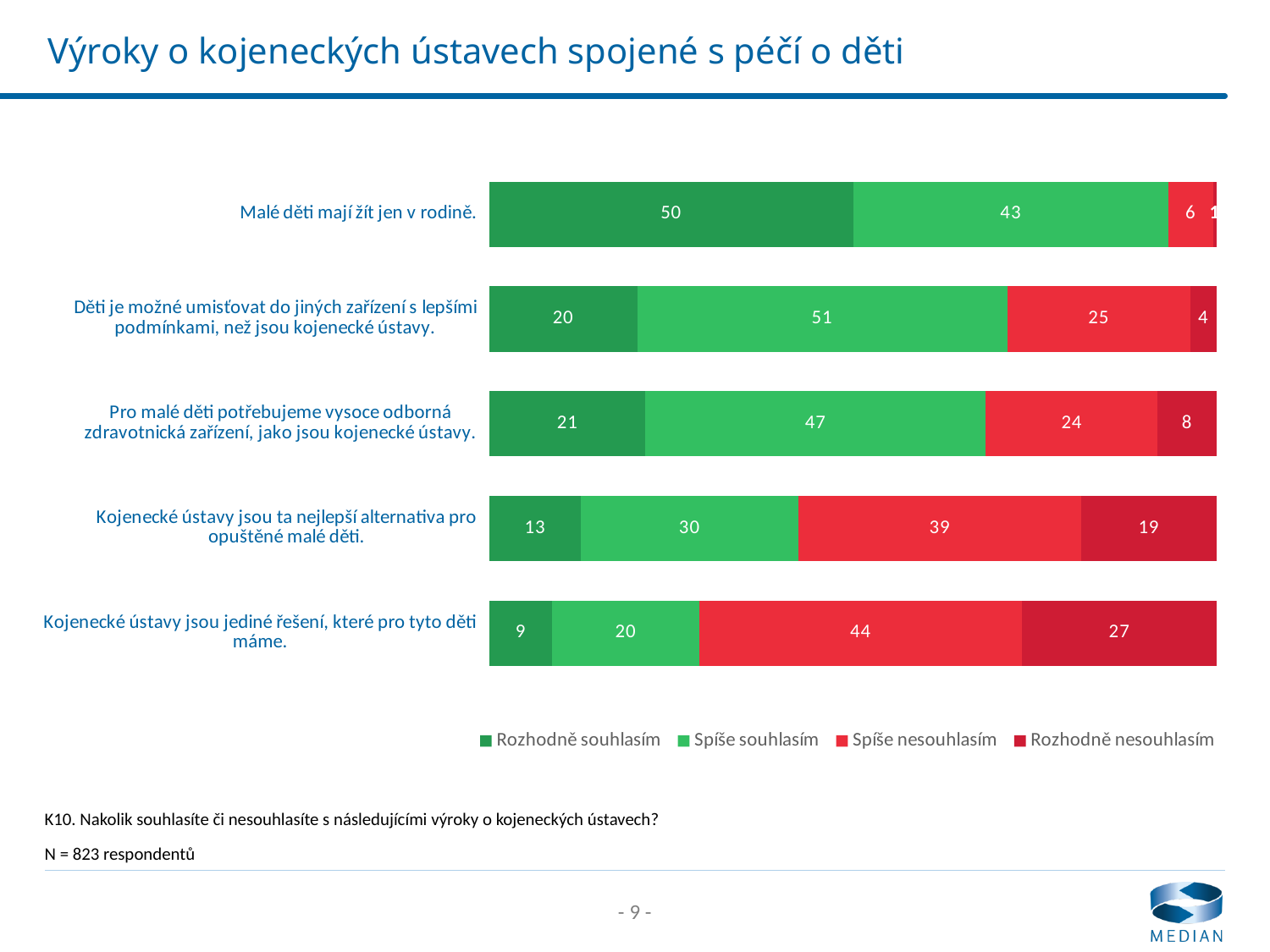
What is the value for "Rozhodně souhlasím" for the statement "Malé děti mají žít jen v rodině."? 50 What is the value for "Spíše nesouhlasím" for the statement "Kojenecké ústavy jsou jediné řešení, které pro tyto děti máme."? 44 How many series does the legend list? 4 What kind of chart is shown on the slide? Stacked bar chart What is the total of the stacked bar for "Pro malé děti potřebujeme vysoce odborná zdravotnická zařízení, jako jsou kojenecké ústavy."? 100 Which legend entry is shown in the darkest green colour? Rozhodně souhlasím Which statement has the lowest value for "Rozhodně souhlasím"? Kojenecké ústavy jsou jediné řešení, které pro tyto děti máme. How many statements are shown in the chart? 5 Which statement has the larger "Spíše nesouhlasím" value: "Kojenecké ústavy jsou ta nejlepší alternativa pro opuštěné malé děti." or "Kojenecké ústavy jsou jediné řešení, které pro tyto děti máme."? Kojenecké ústavy jsou jediné řešení, které pro tyto děti máme. Which statement has the highest value for "Rozhodně souhlasím"? Malé děti mají žít jen v rodině. What is the value for "Rozhodně nesouhlasím" for the statement "Kojenecké ústavy jsou ta nejlepší alternativa pro opuštěné malé děti."? 19 What is the difference between the "Spíše souhlasím" values for "Děti je možné umisťovat do jiných zařízení s lepšími podmínkami, než jsou kojenecké ústavy." and "Kojenecké ústavy jsou jediné řešení, které pro tyto děti máme."? 31